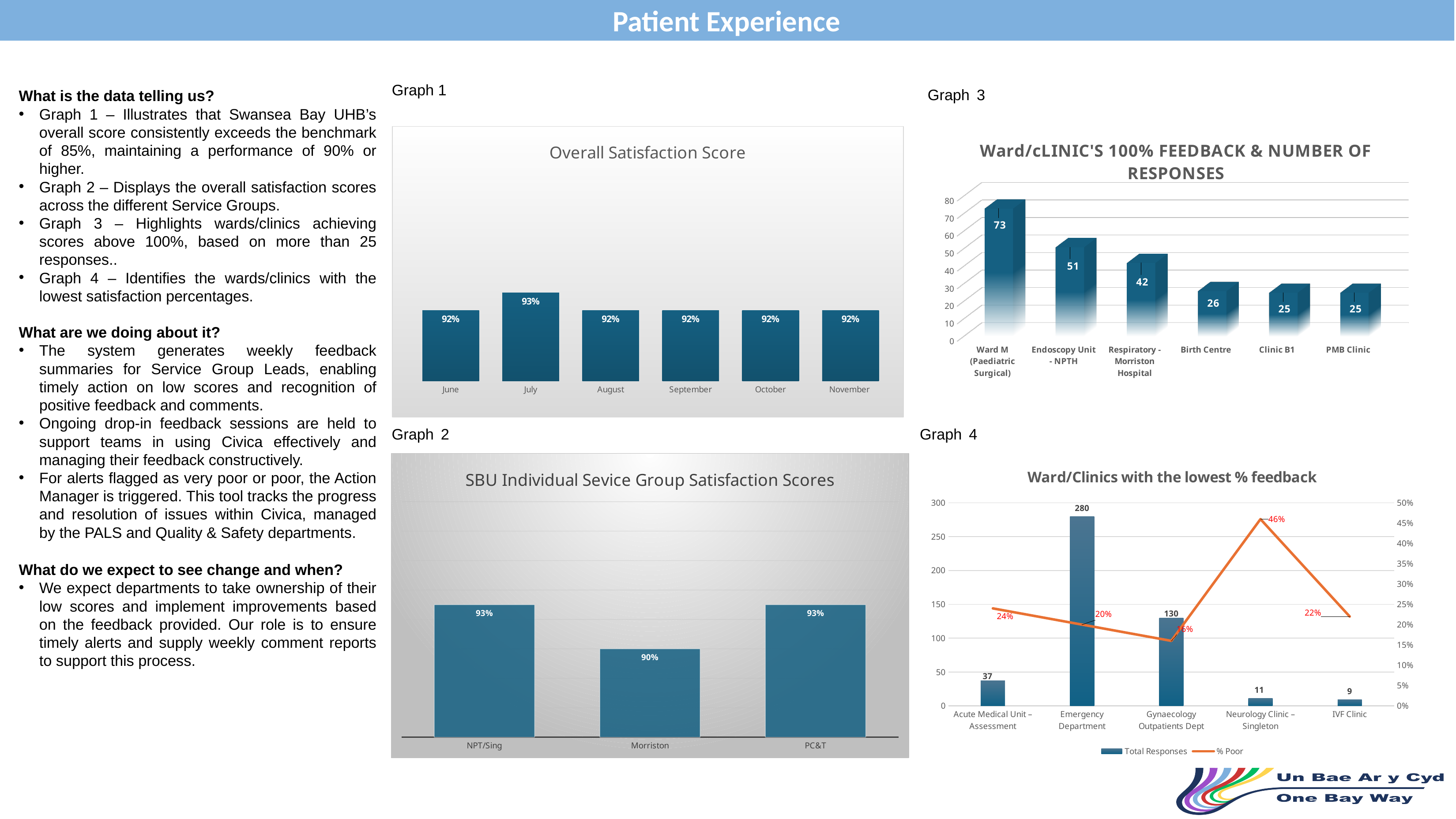
In Graph 1 (Overall Satisfaction Score), what is the value for July? 93% In Graph 3 (Ward/Clinic's 100% Feedback & Number of Responses), which ward/clinic has the highest number of responses? Ward M (Paediatric Surgical) In Graph 4 (Ward/Clinics with the lowest % feedback), which ward/clinic has the highest % Poor? Neurology Clinic – Singleton In Graph 3 (Ward/Clinic's 100% Feedback & Number of Responses), what is the difference in responses between Ward M (Paediatric Surgical) and Respiratory - Morriston Hospital? 31 In Graph 2 (SBU Individual Service Group Satisfaction Scores), what is the value for Morriston? 90% In Graph 2 (SBU Individual Service Group Satisfaction Scores), what is the difference between NPT/Sing and Morriston? 3% In Graph 3 (Ward/Clinic's 100% Feedback & Number of Responses), how many responses did Endoscopy Unit - NPTH have? 51 In Graph 2 (SBU Individual Service Group Satisfaction Scores), which service group has the lowest score? Morriston How many months are plotted in Graph 1 (Overall Satisfaction Score)? 6 In Graph 1 (Overall Satisfaction Score), which month has the highest satisfaction score? July How many series does the legend list in Graph 4 (Ward/Clinics with the lowest % feedback)? 2 In Graph 4 (Ward/Clinics with the lowest % feedback), what is the Total Responses value for Emergency Department? 280